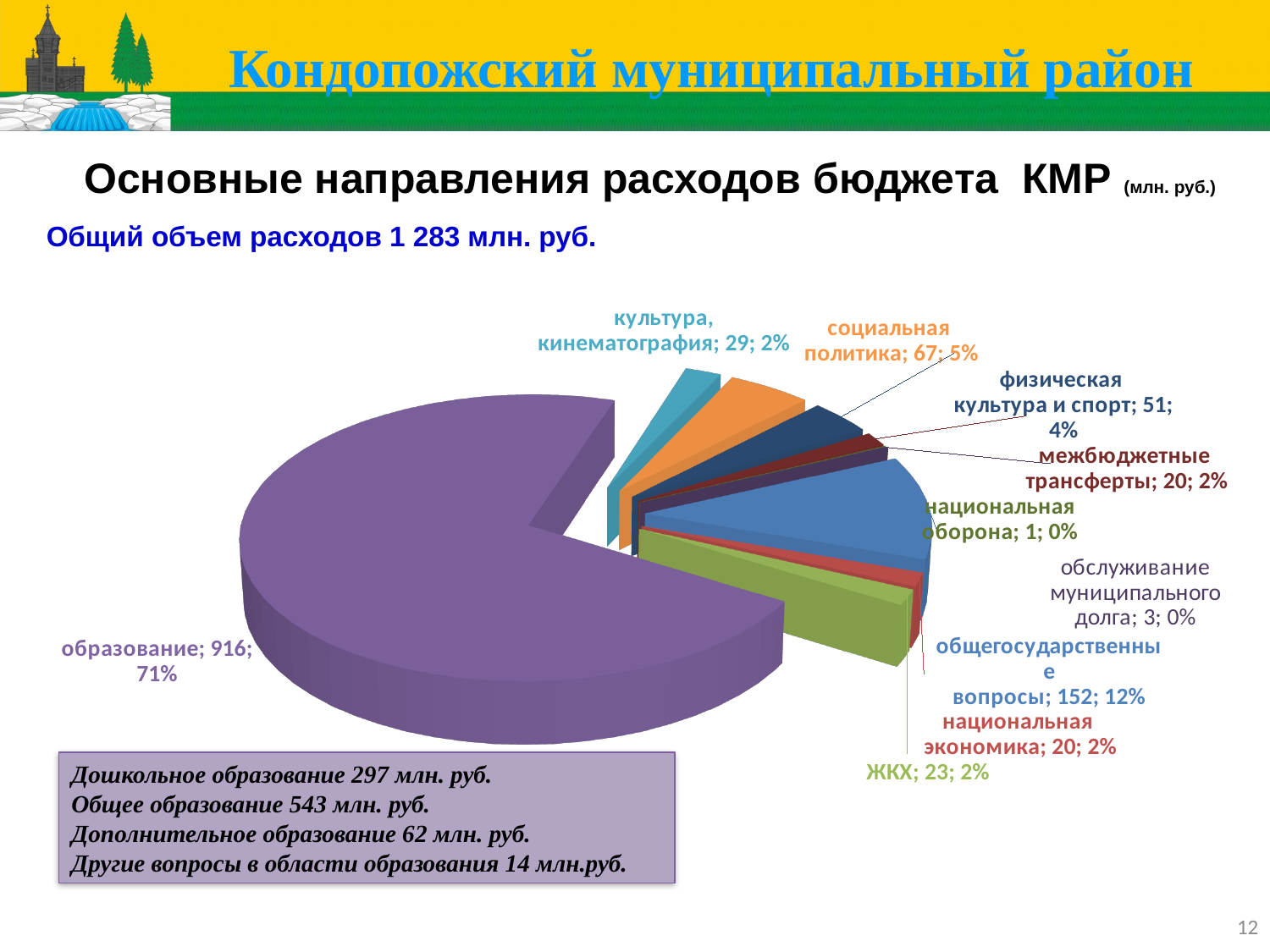
What share of the pie does образование take? 71% Which category has the smallest value in the pie chart? национальная оборона Which is larger, the value for ЖКХ or the value for культура, кинематография? культура, кинематография What total expenditure volume is stated above the chart? 1 283 млн. руб. What is the value for физическая культура и спорт? 51 What is the value for общегосударственные вопросы? 152 What is the difference between the values for общегосударственные вопросы and социальная политика? 85 How many categories are shown in the pie chart? 10 What is the value for образование in the pie chart? 916 What share of the pie does социальная политика take? 5% Which category has the largest slice of the pie? образование What kind of chart is shown on the slide? pie chart